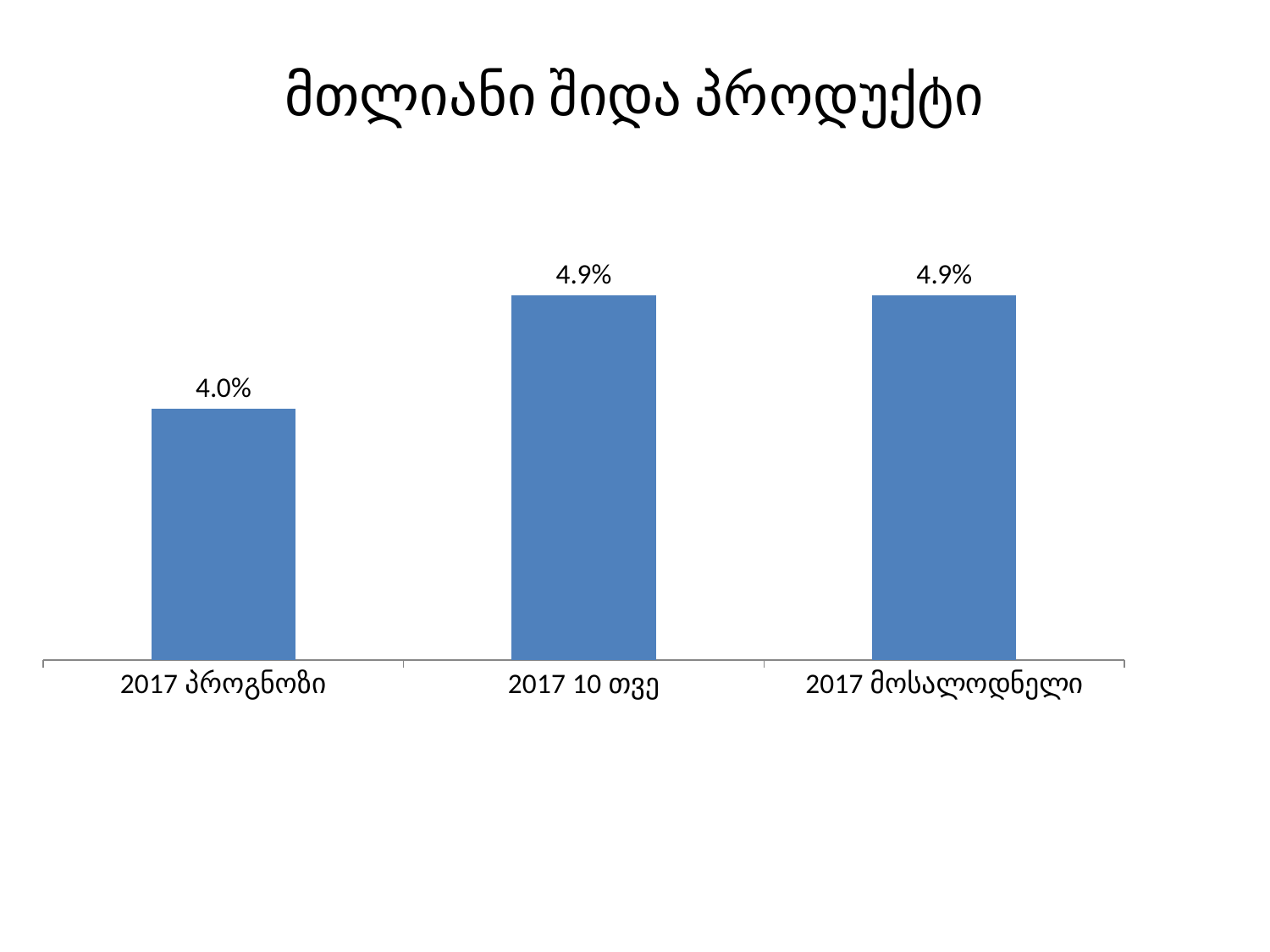
What is the value for 2017 10 თვე? 4.9% Which is larger, the value for 2017 პროგნოზი or the value for 2017 მოსალოდნელი? 2017 მოსალოდნელი Which category has the lowest value? 2017 პროგნოზი What is the difference between the values for 2017 10 თვე and 2017 პროგნოზი? 0.9 percentage points What is the title of the chart? მთლიანი შიდა პროდუქტი How many categories are shown on the chart? 3 What is the value for 2017 პროგნოზი? 4.0% Do the values rise or fall from 2017 პროგნოზი to 2017 10 თვე? rise What is the value for 2017 მოსალოდნელი? 4.9% What kind of chart is shown on the slide? bar chart Is the value for 2017 10 თვე greater or less than the value for 2017 პროგნოზი? greater What colour are the bars in the chart? blue